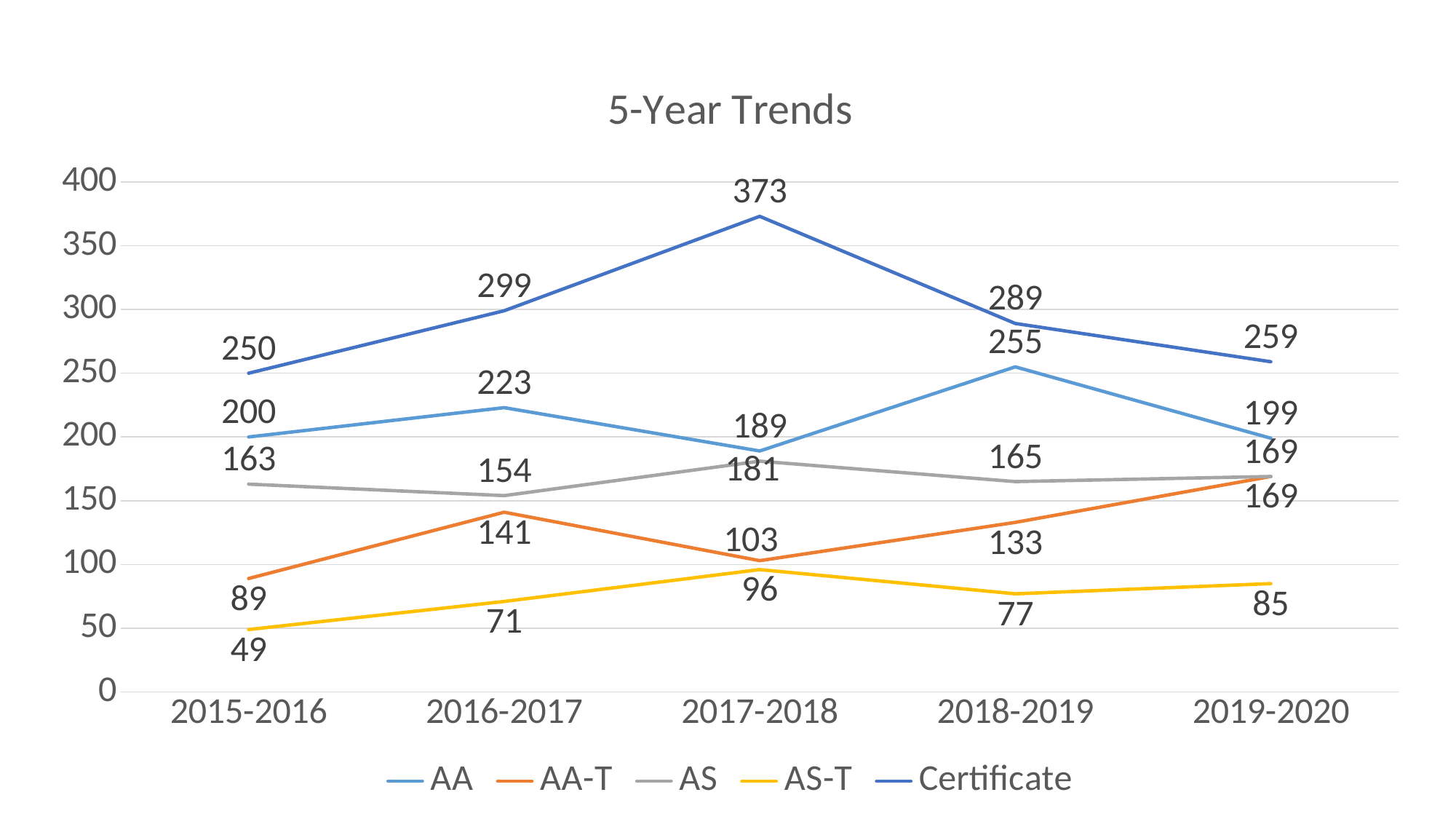
What type of chart is shown on the slide? line chart What is the title of the chart? 5-Year Trends What is the AS-T value for 2015-2016? 49 In which year is the AA-T value lowest? 2015-2016 How many series does the legend list? 5 What is the Certificate value for 2017-2018? 373 Does the AS-T series rise or fall from 2015-2016 to 2017-2018? rise Which is larger in 2016-2017, the AA-T value or the AS value? AS In which year does the Certificate series reach its highest value? 2017-2018 What is the AA value for 2018-2019? 255 How many academic years are shown on the x axis? 5 What is the difference between the Certificate value and the AA value in 2017-2018? 184